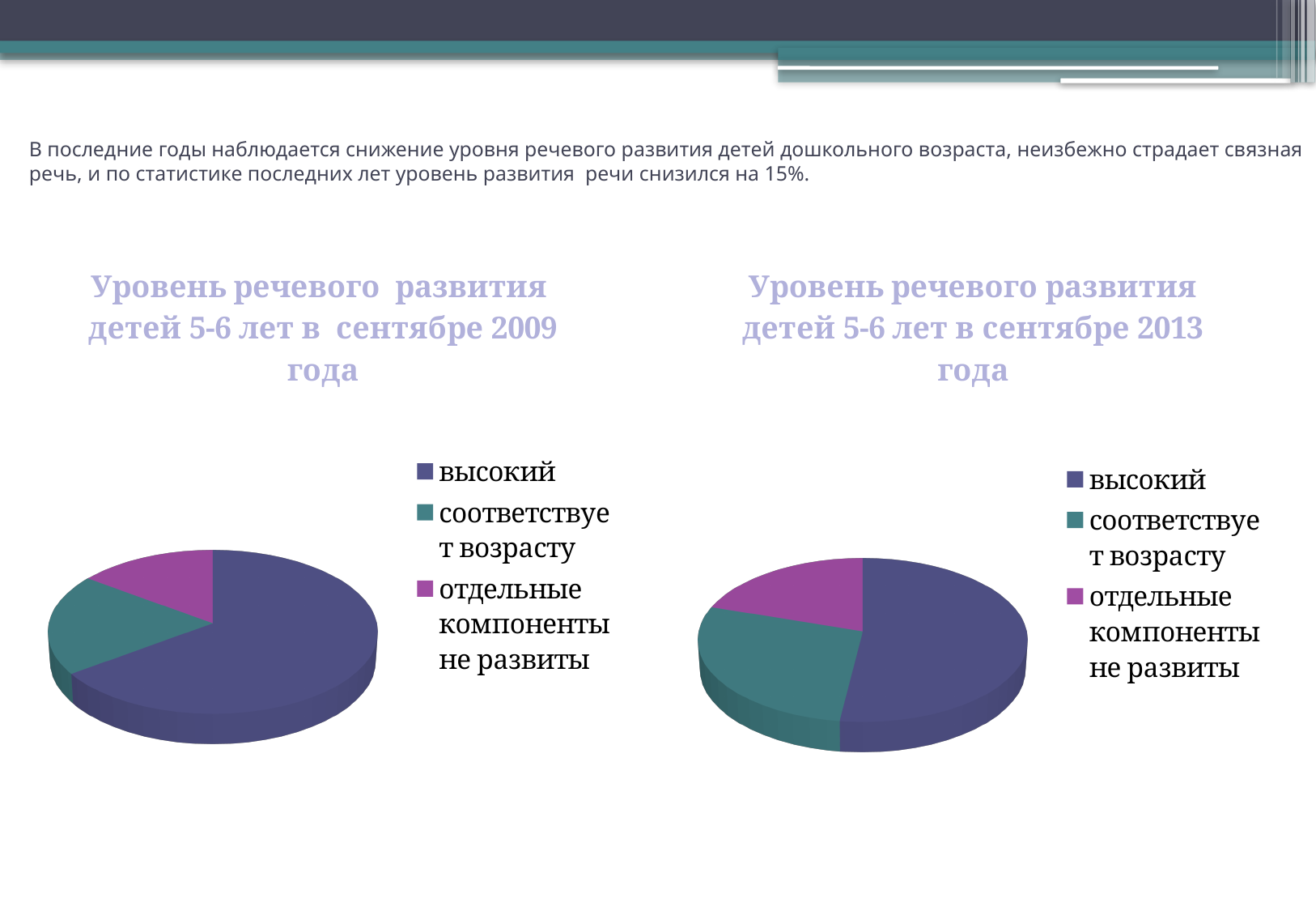
How many slices does the left chart (September 2009) have? 3 In the left chart (September 2009), which category has the largest slice? высокий What kind of chart is the right chart, 'Уровень речевого развития детей 5-6 лет в сентябре 2013 года'? Pie chart In the right chart (September 2013), which slice is larger: 'соответствует возрасту' or 'отдельные компоненты не развиты'? соответствует возрасту What colour represents 'отдельные компоненты не развиты' in the legend of the right chart (September 2013)? Purple In the right chart (September 2013), which category has the smallest slice? отдельные компоненты не развиты How many slices does the right chart (September 2013) have? 3 In the left chart (September 2009), which slice is larger: 'высокий' or 'соответствует возрасту'? высокий In the right chart (September 2013), which category has the largest slice? высокий How many entries does the legend of the left chart (September 2009) list? 3 What kind of chart is the left chart, 'Уровень речевого развития детей 5-6 лет в сентябре 2009 года'? Pie chart What is the title of the left chart? Уровень речевого развития детей 5-6 лет в сентябре 2009 года